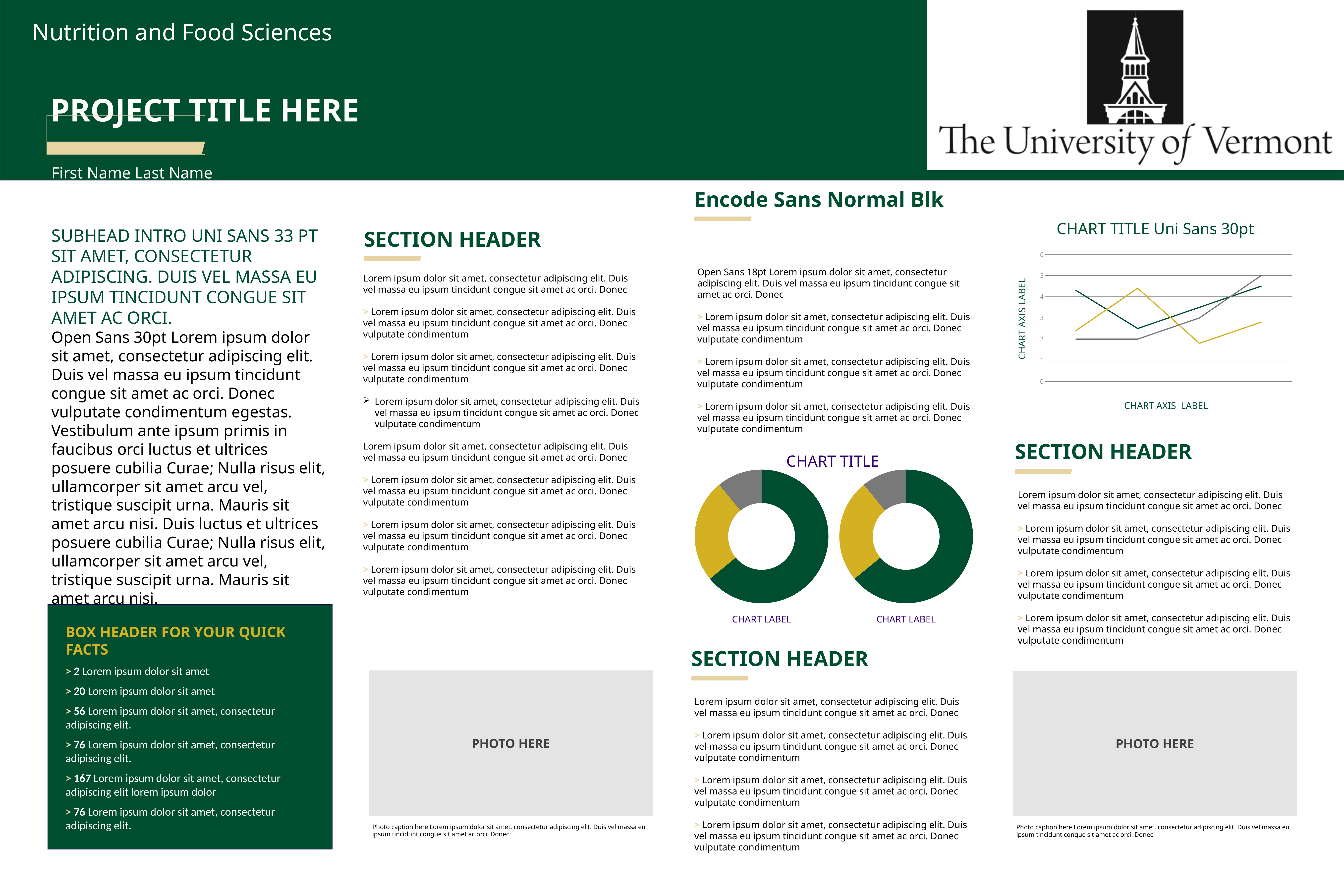
In the left doughnut chart under "CHART TITLE", which colour segment is the largest? green What is the label printed under each of the two doughnut charts? CHART LABEL How many lines are plotted in the line chart titled "CHART TITLE Uni Sans 30pt"? 3 In the line chart titled "CHART TITLE Uni Sans 30pt", what is the highest value shown on the vertical axis? 6 In the line chart titled "CHART TITLE Uni Sans 30pt", is the highest point reached by the gray line greater or less than 4? greater In the line chart titled "CHART TITLE Uni Sans 30pt", does the gray line rise or fall from its first point to its last point? rise What kind of charts are the two charts under the heading "CHART TITLE" in the middle of the slide? doughnut (pie) charts How many doughnut charts are shown under the heading "CHART TITLE"? 2 In the line chart titled "CHART TITLE Uni Sans 30pt", is the lowest point of the yellow line greater or less than 3? less In the line chart titled "CHART TITLE Uni Sans 30pt", is the first point of the green line greater or less than 3? greater In the right doughnut chart under "CHART TITLE", which colour segment is the smallest? gray What kind of chart is the chart titled "CHART TITLE Uni Sans 30pt" at the top right of the slide? line chart